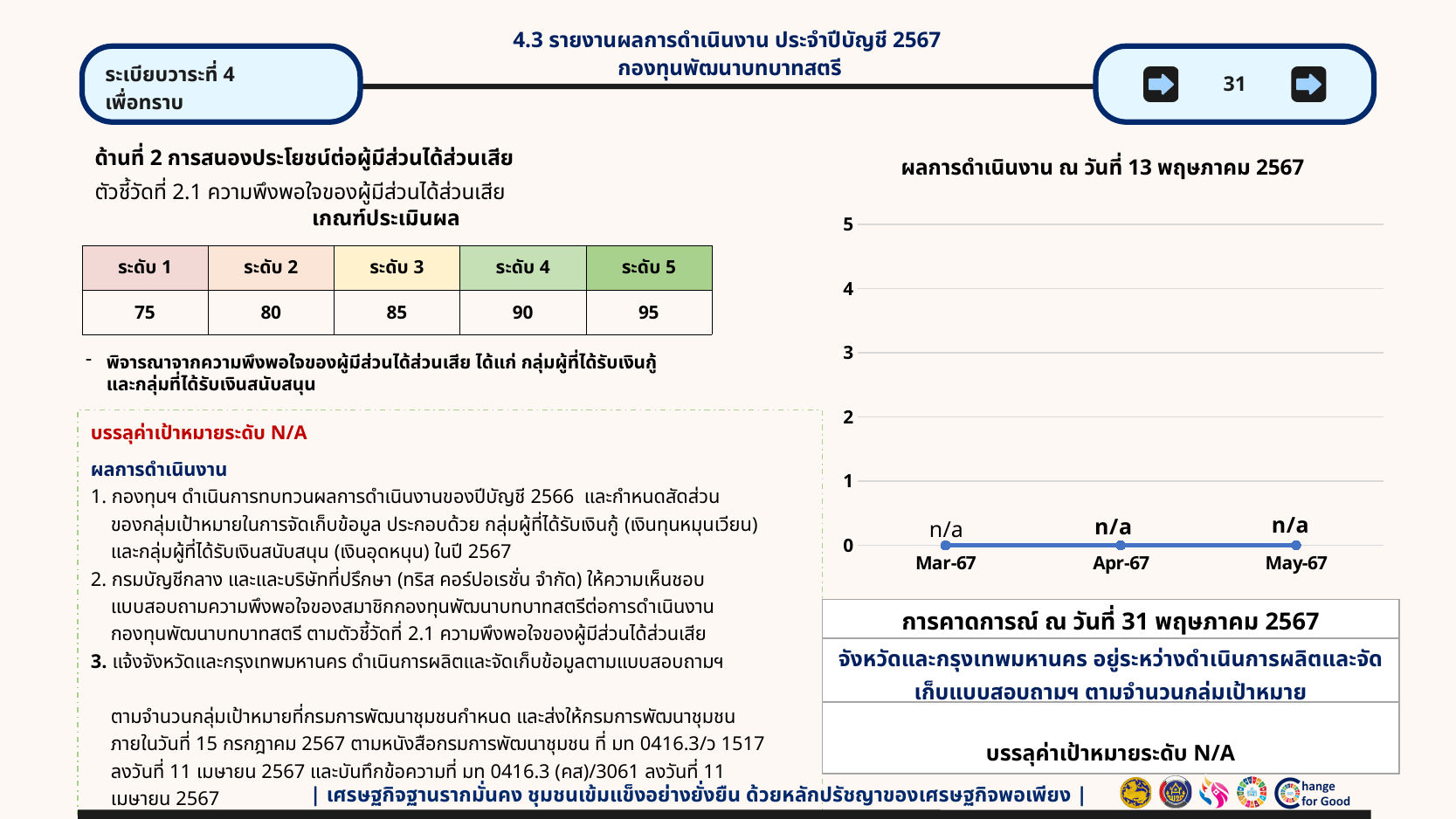
Is the plotted value for Mar-67 greater or less than 2? less What is the data label shown for Apr-67 on the chart? n/a Is the plotted value for May-67 greater or less than 1? less What is the data label shown for Mar-67 on the chart? n/a Do the plotted values rise, fall, or stay flat from Mar-67 to May-67? stay flat What kind of chart is shown on the slide? line chart What is the first category on the x axis of the chart? Mar-67 How many data points are plotted on the chart? 3 What is the highest value shown on the chart's y axis? 5 What is the data label shown for May-67 on the chart? n/a